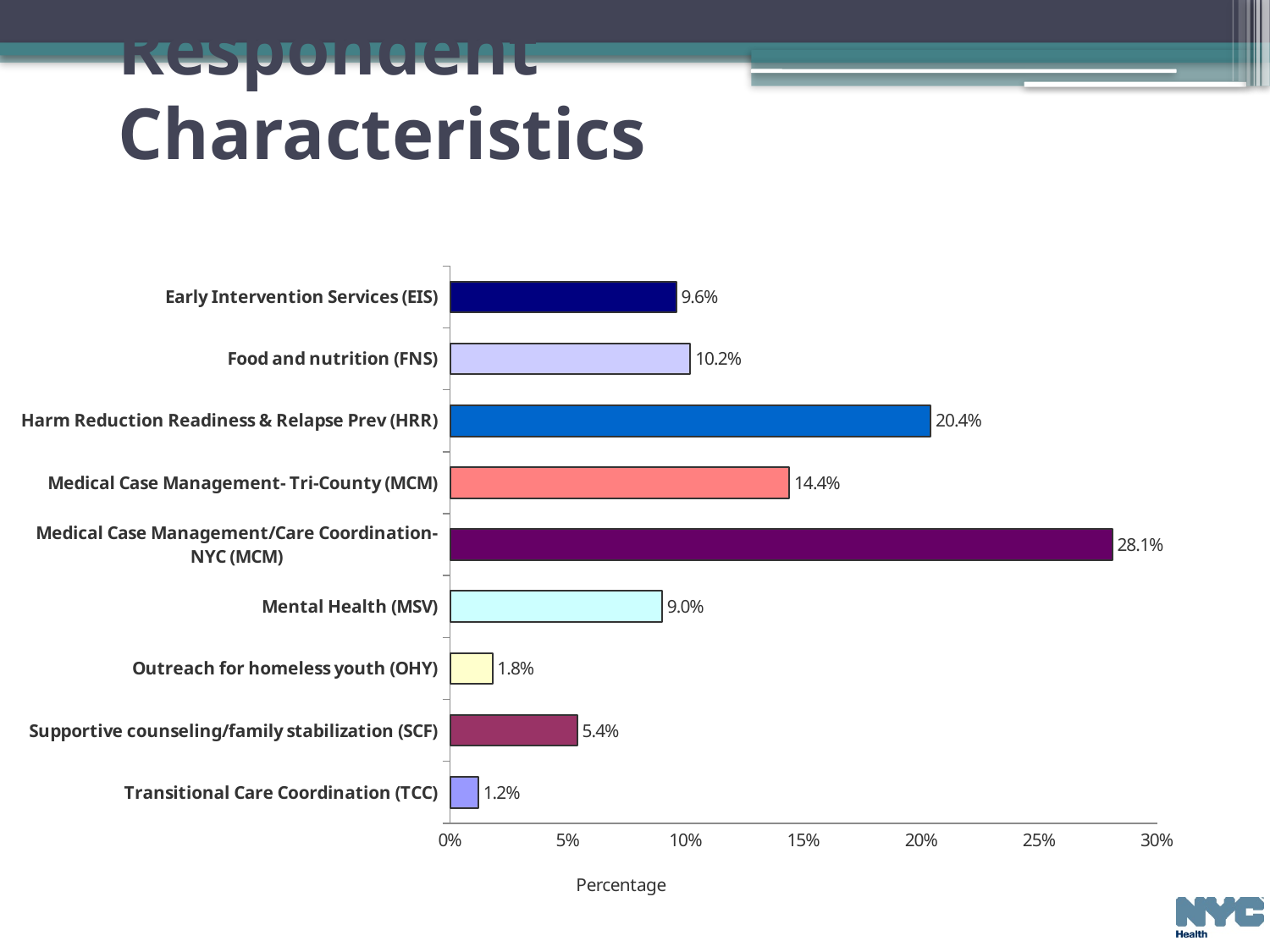
What percentage is shown for Transitional Care Coordination (TCC)? 1.2% What is the difference between the values for Outreach for homeless youth (OHY) and Transitional Care Coordination (TCC)? 0.6% What kind of chart is shown on the slide? bar chart What is the label on the horizontal axis of the chart? Percentage What percentage is shown for Harm Reduction Readiness & Relapse Prev (HRR)? 20.4% How many categories are shown in the chart? 9 Which is larger, the value for Food and nutrition (FNS) or Early Intervention Services (EIS)? Food and nutrition (FNS) What is the difference between the values for Medical Case Management/Care Coordination-NYC (MCM) and Medical Case Management- Tri-County (MCM)? 13.7% Which category has the lowest percentage? Transitional Care Coordination (TCC) Is the value for Supportive counseling/family stabilization (SCF) greater or less than 10%? less Which category has the highest percentage? Medical Case Management/Care Coordination-NYC (MCM) What is the value for Mental Health (MSV)? 9.0%